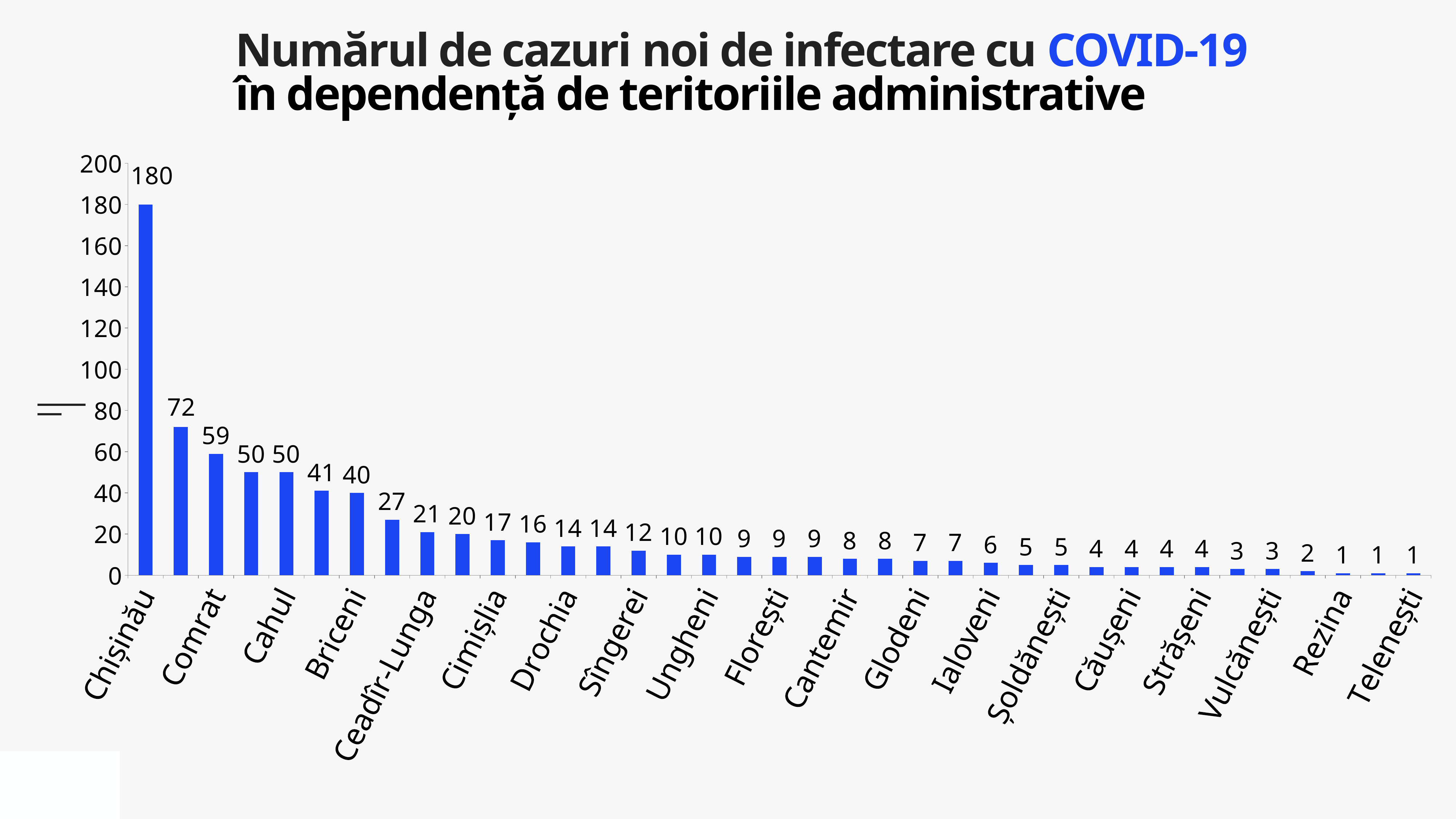
Is the value for Chișinău greater or less than 160? greater How many bars are plotted in the chart? 37 What is the number of new cases for Chișinău? 180 Do the values rise or fall from left to right along the x axis? fall What is the title of the chart? Numărul de cazuri noi de infectare cu COVID-19 în dependență de teritoriile administrative Which territory has the highest number of new COVID-19 cases? Chișinău Which has more new cases, Chișinău or Comrat? Chișinău What type of chart is shown on the slide? bar chart Is the value for Comrat greater or less than 100? less What is the difference between the highest value (180) and the second highest value (72)? 108 What is the number of new cases for Telenești, the last bar on the right? 1 What is the number of new cases for Rezina? 1